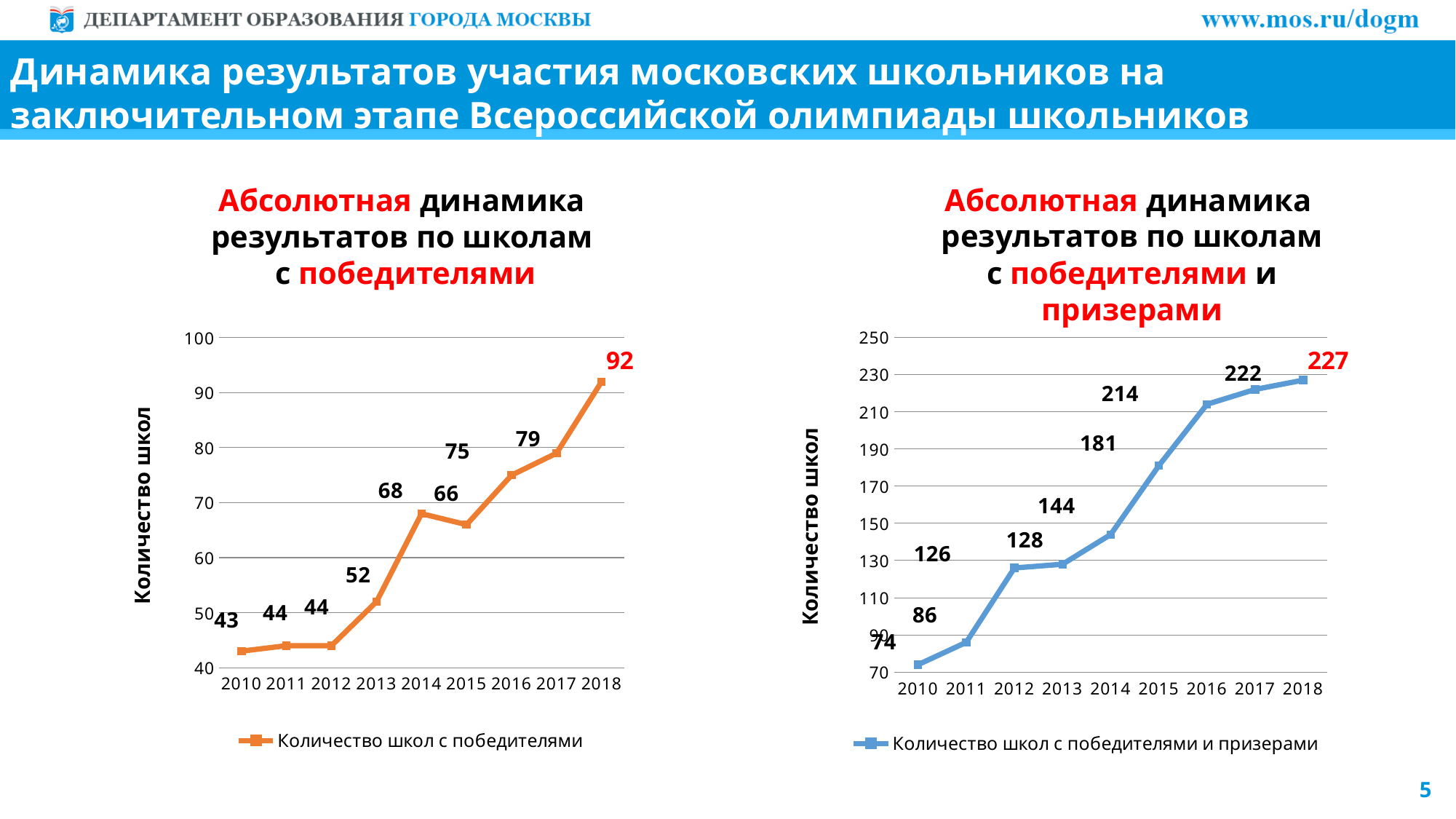
In the left chart (schools with winners), which year has the lowest value? 2010 In the left chart (schools with winners), what is the value for 2018? 92 In the right chart (schools with winners and prize-winners), which year has the highest value? 2018 In the right chart (schools with winners and prize-winners), what is the difference between the 2016 and 2015 values? 33 In the right chart (schools with winners and prize-winners), what is the value for 2010? 74 In the right chart (schools with winners and prize-winners), what is the value for 2015? 181 In the left chart (schools with winners), which is larger: the value for 2014 or the value for 2015? 2014 In the left chart (schools with winners), what is the difference between the 2018 and 2010 values? 49 What type of chart is the left chart (schools with winners)? Line chart How many years are plotted on the x axis of the right chart (schools with winners and prize-winners)? 9 In the right chart (schools with winners and prize-winners), do the values generally rise or fall from 2010 to 2018? Rise In the left chart (schools with winners), what is the value for 2014? 68